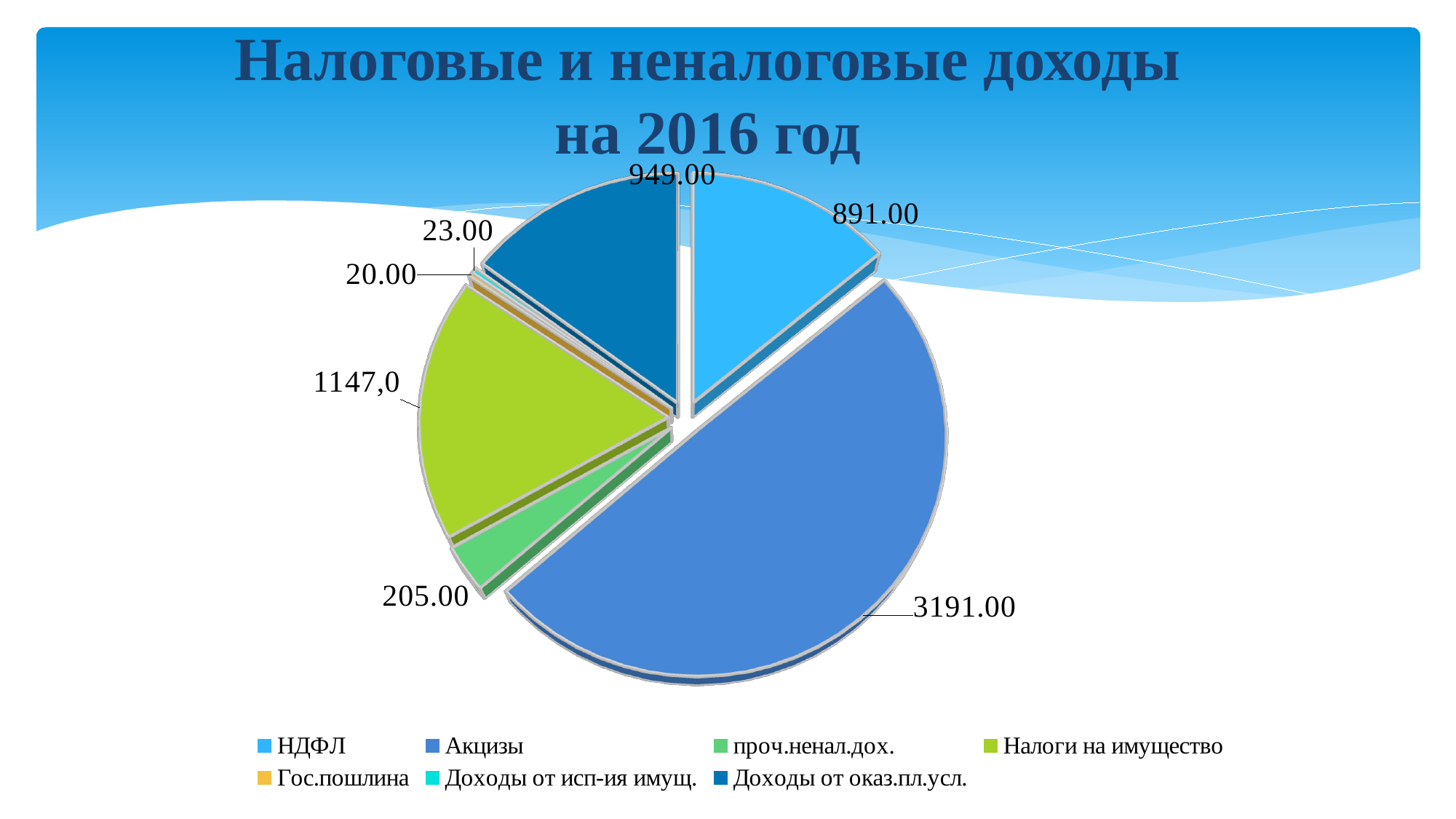
Which is larger, the value for проч.ненал.дох. or the value for Налоги на имущество? Налоги на имущество What is the difference between the values for Акцизы and НДФЛ? 2300.00 Which category has the smallest value? Гос.пошлина What is the value for НДФЛ? 891.00 How many categories does the legend list? 7 What is the value for Акцизы? 3191.00 What is the value for Доходы от оказ.пл.усл.? 949.00 Which category has the largest slice of the pie? Акцизы What type of chart is shown on the slide? Pie chart What is the difference between the values for Доходы от оказ.пл.усл. and НДФЛ? 58.00 What is the value for Налоги на имущество? 1147,0 What is the value for Гос.пошлина? 20.00